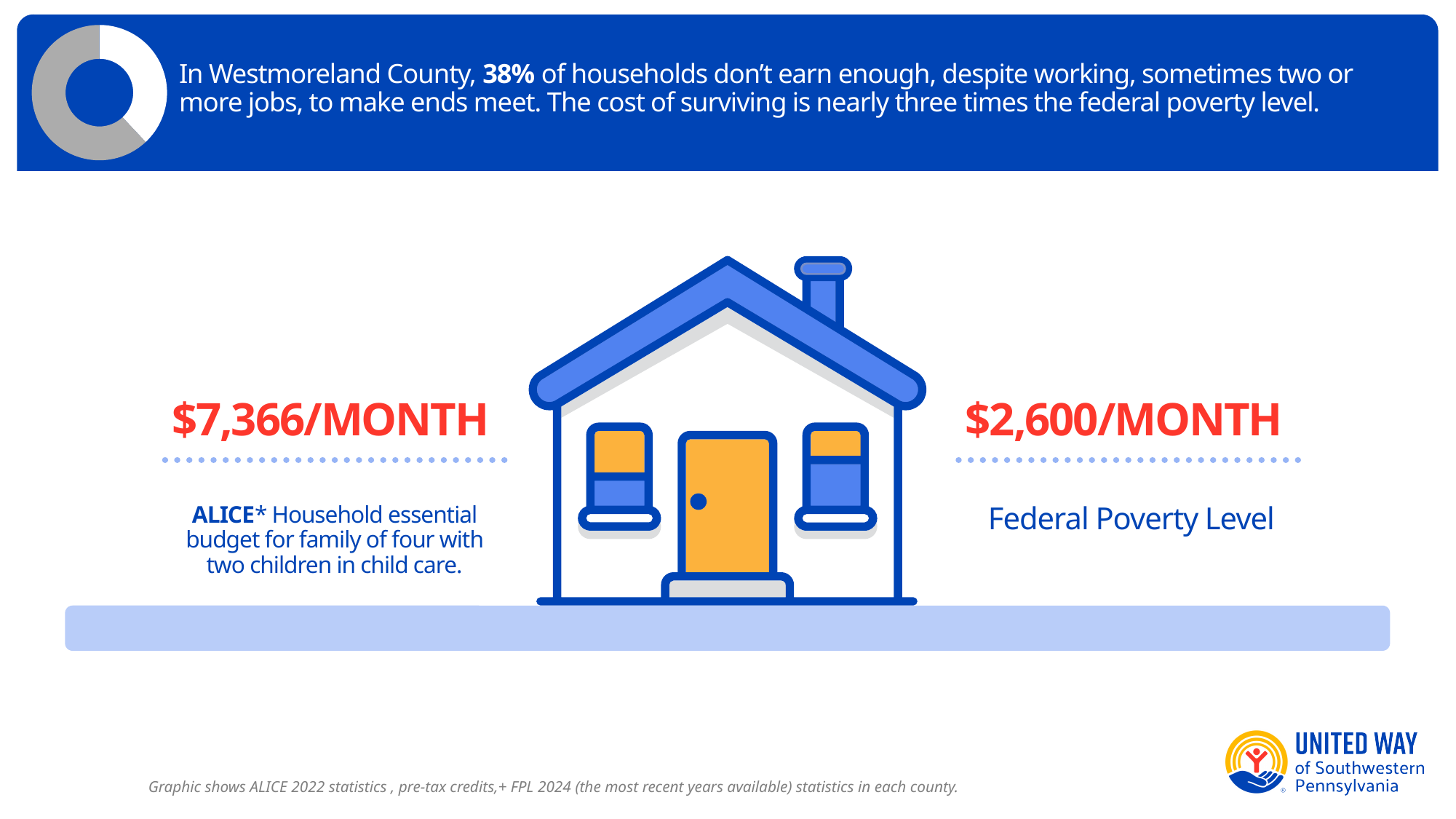
How many slices does the donut chart in the top-left have? 2 What kind of chart is shown in the top-left corner of the slide? Donut (pie) chart In the donut chart, which slice is larger, the blue one or the gray one? The gray one What is the difference between the ALICE Household essential budget ($7,366/month) and the Federal Poverty Level ($2,600/month)? $4,766/month What colour is the slice of the donut chart that represents the 38% of households? Blue What share of the donut chart does the gray slice represent, given the blue slice is 38%? 62% What is the ALICE Household essential budget per month shown on the slide? $7,366/MONTH Is the blue slice of the donut chart greater or less than 50% of the whole? less Which monthly figure is larger, the ALICE Household essential budget or the Federal Poverty Level? ALICE Household essential budget What is the Federal Poverty Level per month shown on the slide? $2,600/MONTH Which county does the donut chart's 38% figure refer to? Westmoreland County What percentage of households in Westmoreland County does the blue slice of the donut chart represent? 38%